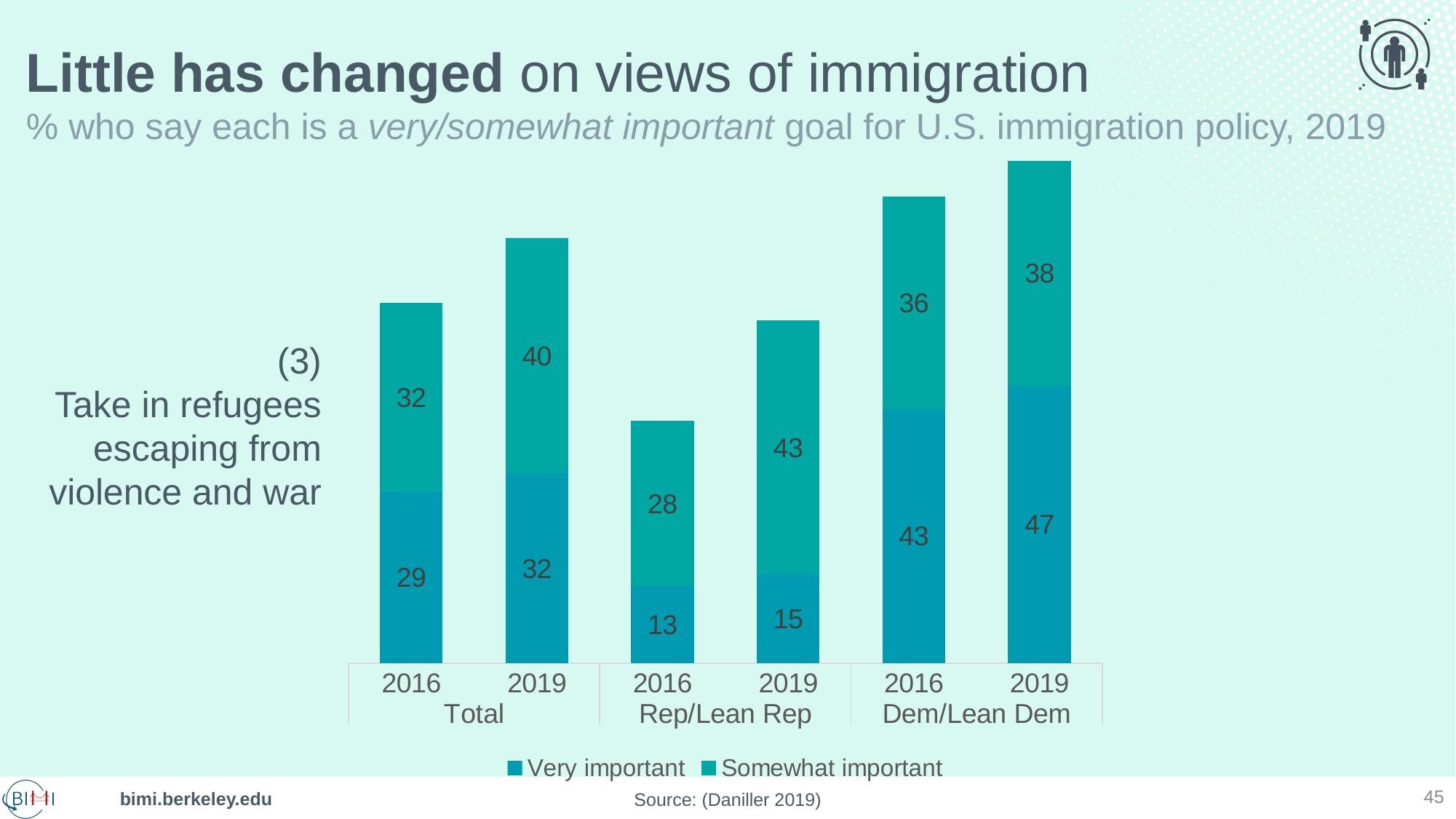
Which bar has the highest 'Very important' value? Dem/Lean Dem 2019 Which bar has the lowest 'Very important' value? Rep/Lean Rep 2016 How many series does the legend list? 2 What kind of chart is shown on the slide? Stacked bar chart What is the 'Very important' value for Dem/Lean Dem in 2019? 47 What is the 'Very important' value for Rep/Lean Rep in 2016? 13 What is the 'Somewhat important' value for Total in 2019? 40 Which is larger: the 'Very important' value for Total in 2019 or for Rep/Lean Rep in 2019? Total 2019 What is the total of the stacked bar for Dem/Lean Dem in 2016? 79 What is the difference between the 'Somewhat important' values for Rep/Lean Rep in 2019 and 2016? 15 Which legend entry is shown in the darker teal colour at the bottom of each bar? Very important How many bars are plotted in the chart? 6